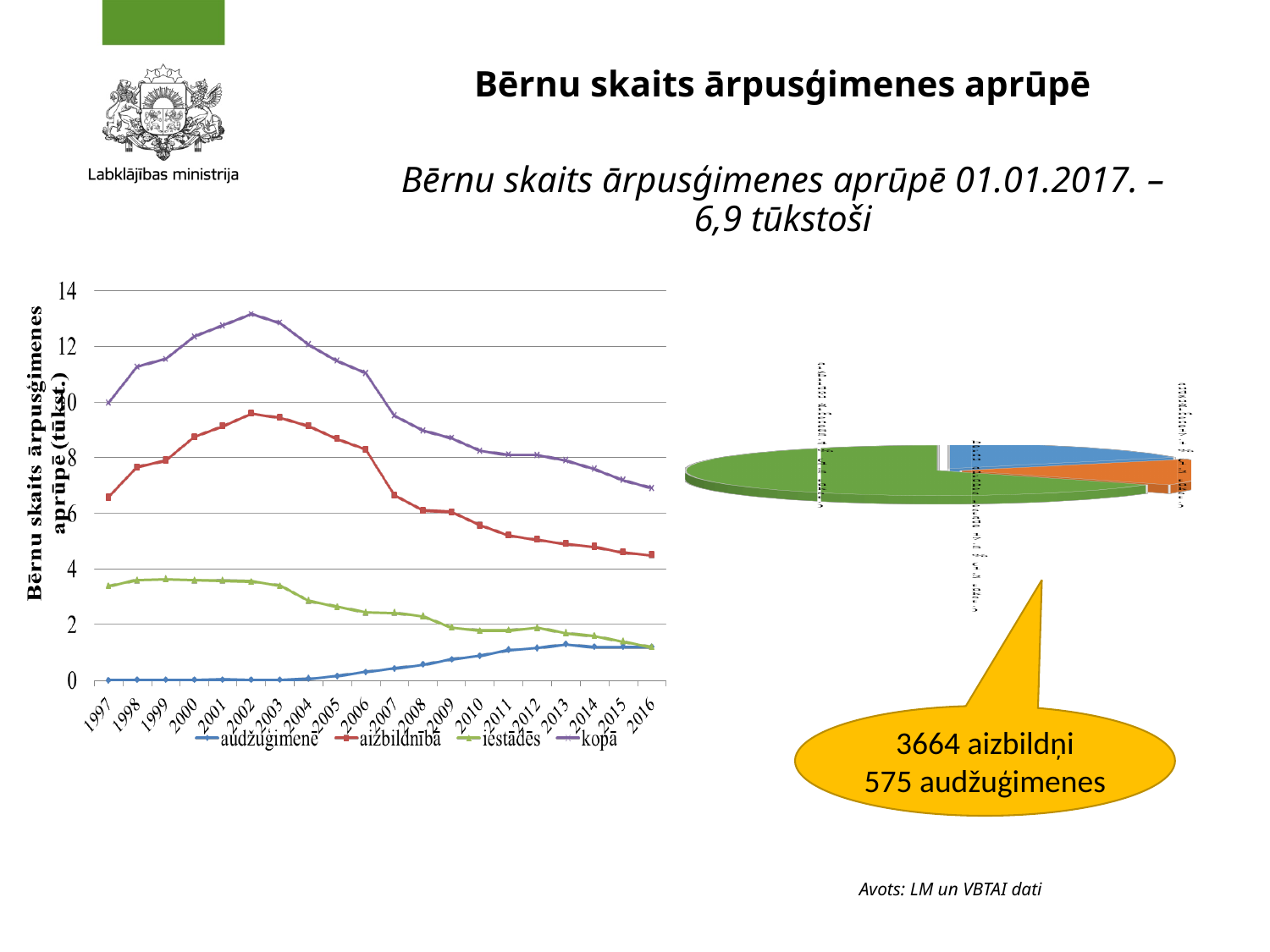
In the line chart on the left, is the value of 'audžuģimenē' in 2005 greater or less than 2? less What kind of chart is the chart on the left of the slide? line chart In the line chart on the left, in which year does the 'kopā' series reach its highest value? 2002 In the line chart on the left, does the 'audžuģimenē' series rise or fall from 1997 to 2016? rise In the line chart on the left, how many series does the legend list? 4 In the line chart on the left, in which year is the 'kopā' series at its lowest value? 2016 In the line chart on the left, how many years are shown on the x axis? 20 In the line chart on the left, is the value of 'kopā' in 1997 greater or less than 8? greater What kind of chart is the chart on the right of the slide? pie chart In the line chart on the left, is the value of 'aizbildnībā' in 2016 greater or less than 6? less In the line chart on the left, what is the label of the y axis? Bērnu skaits ārpusģimenes aprūpē (tūkst.) In the line chart on the left, which series has the larger value in 2016: 'aizbildnībā' or 'iestādēs'? aizbildnībā